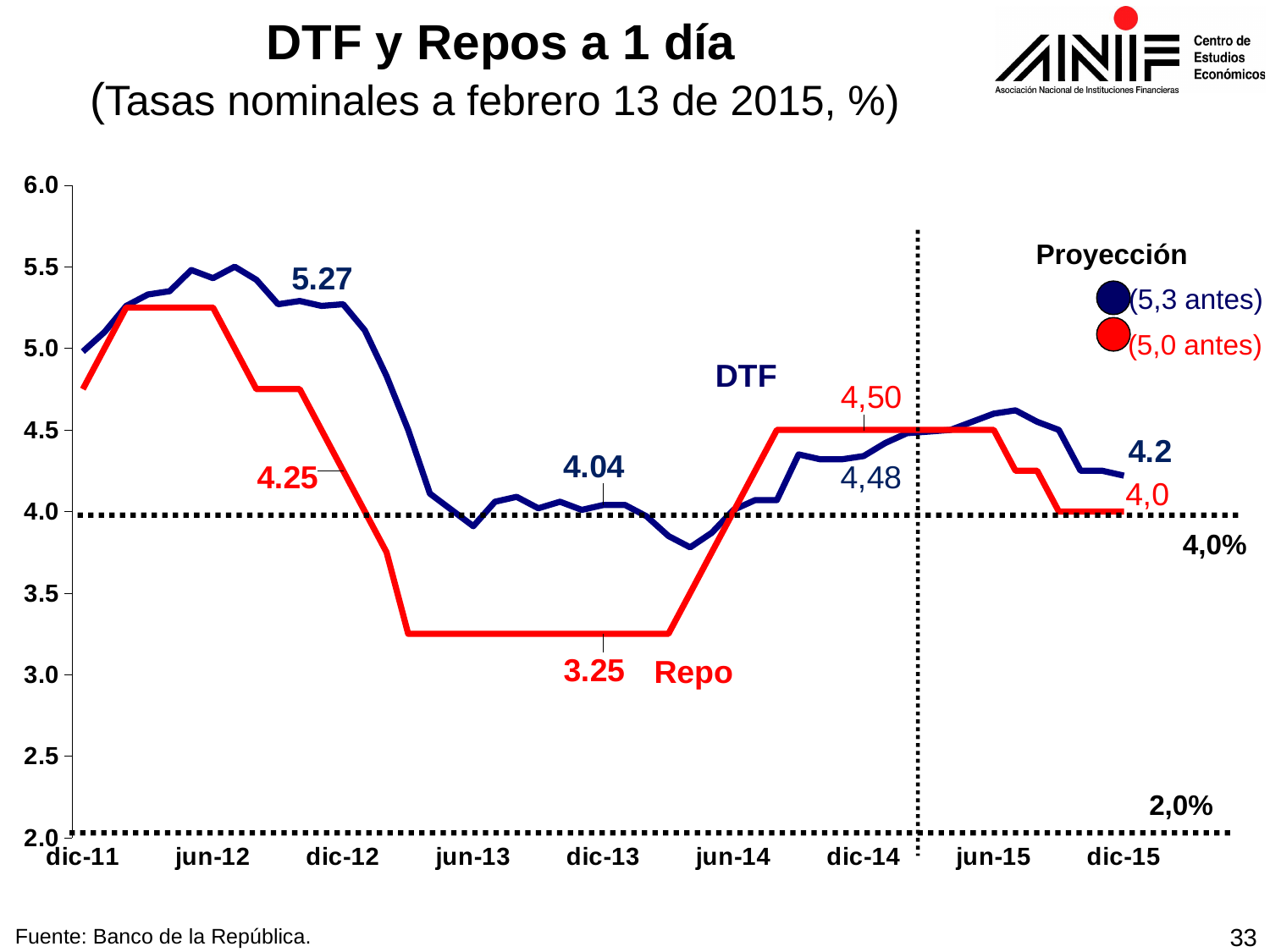
What value is labelled on the DTF line around dic-14? 4,48 Is the Repo value at jun-13 greater or less than 3.5? less According to the projection legend, what was the previous projection for the DTF (blue) series? 5,3 Is the DTF value at jun-12 greater or less than 5.0? greater Does the Repo line rise or fall between dic-12 and jun-13? fall What value is labelled on the Repo line around dic-14? 4,50 What is the difference between the projected DTF value (4.2) and the projected Repo value (4,0) at dic-15? 0.2 What is the projected Repo value labelled at dic-15? 4,0 What kind of chart is shown on the slide? line chart What is the projected DTF value labelled at dic-15? 4.2 How many series are plotted in the chart? 2 What value is labelled on the Repo line during its flat stretch through 2013? 3.25